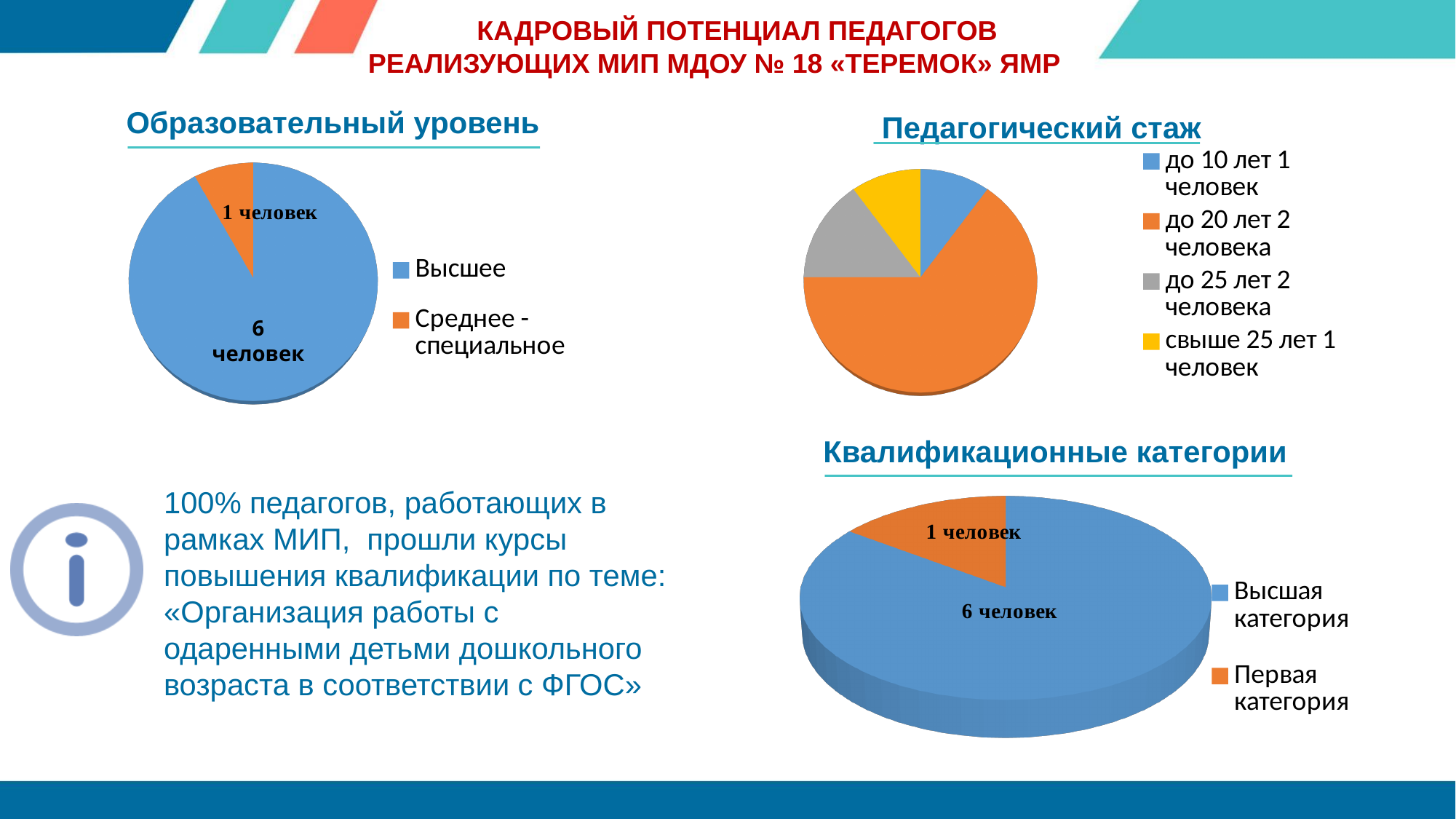
In the 'Образовательный уровень' pie chart, how many people have 'Среднее - специальное' education? 1 человек In the 'Образовательный уровень' pie chart, which category is the largest? Высшее In the 'Педагогический стаж' pie chart, which colour represents 'до 25 лет 2 человека'? Grey How many categories does the 'Педагогический стаж' pie chart show? 4 In the 'Квалификационные категории' pie chart, how many people have 'Высшая категория'? 6 человек In the 'Педагогический стаж' pie chart, what is the total number of people across all categories? 6 In the 'Образовательный уровень' pie chart, what is the difference between the 'Высшее' and 'Среднее - специальное' values? 5 In the 'Педагогический стаж' pie chart, how many people have 'свыше 25 лет' of experience? 1 человек In the 'Педагогический стаж' pie chart, how many people have 'до 20 лет' of experience? 2 человека In the 'Квалификационные категории' pie chart, which category is the smallest? Первая категория What type of chart is used for 'Квалификационные категории'? Pie chart In the 'Образовательный уровень' pie chart, how many people have 'Высшее' education? 6 человек